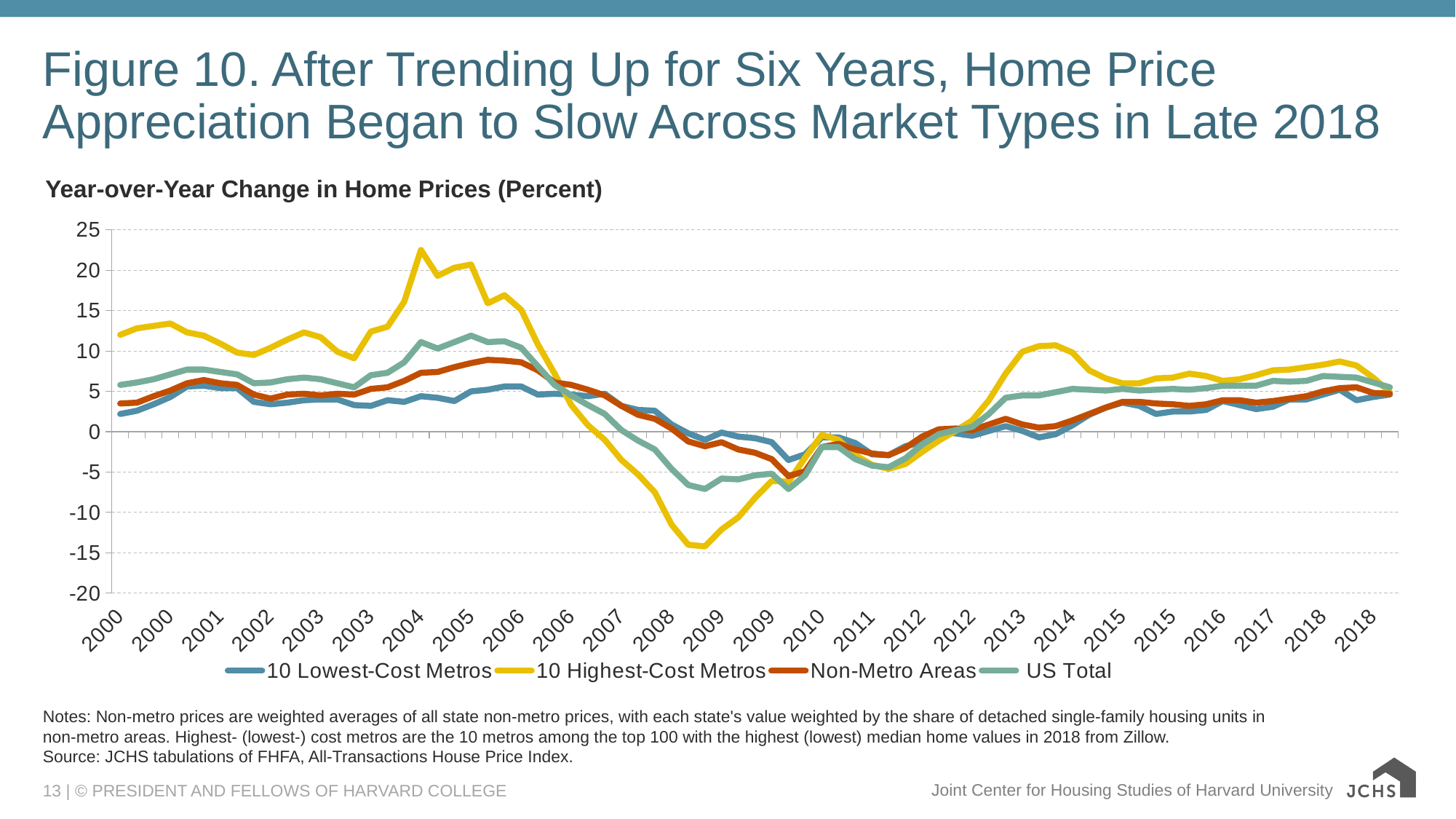
Is the value for 10 Lowest-Cost Metros at the start of the chart in 2000 greater or less than 5? less Is the lowest value for 10 Highest-Cost Metros around 2009 greater or less than -10? less Which series reaches the highest peak on the chart? 10 Highest-Cost Metros Which series is drawn in yellow? 10 Highest-Cost Metros Is the peak value for 10 Highest-Cost Metros around 2004 greater or less than 20? greater Around 2004, which series is higher: 10 Highest-Cost Metros or US Total? 10 Highest-Cost Metros What is the axis label shown above the chart? Year-over-Year Change in Home Prices (Percent) How many series does the legend list? 4 Does the 10 Highest-Cost Metros series rise or fall between 2006 and 2009? Fall Which series falls to the lowest value on the chart? 10 Highest-Cost Metros What kind of chart is shown on the slide? Line chart